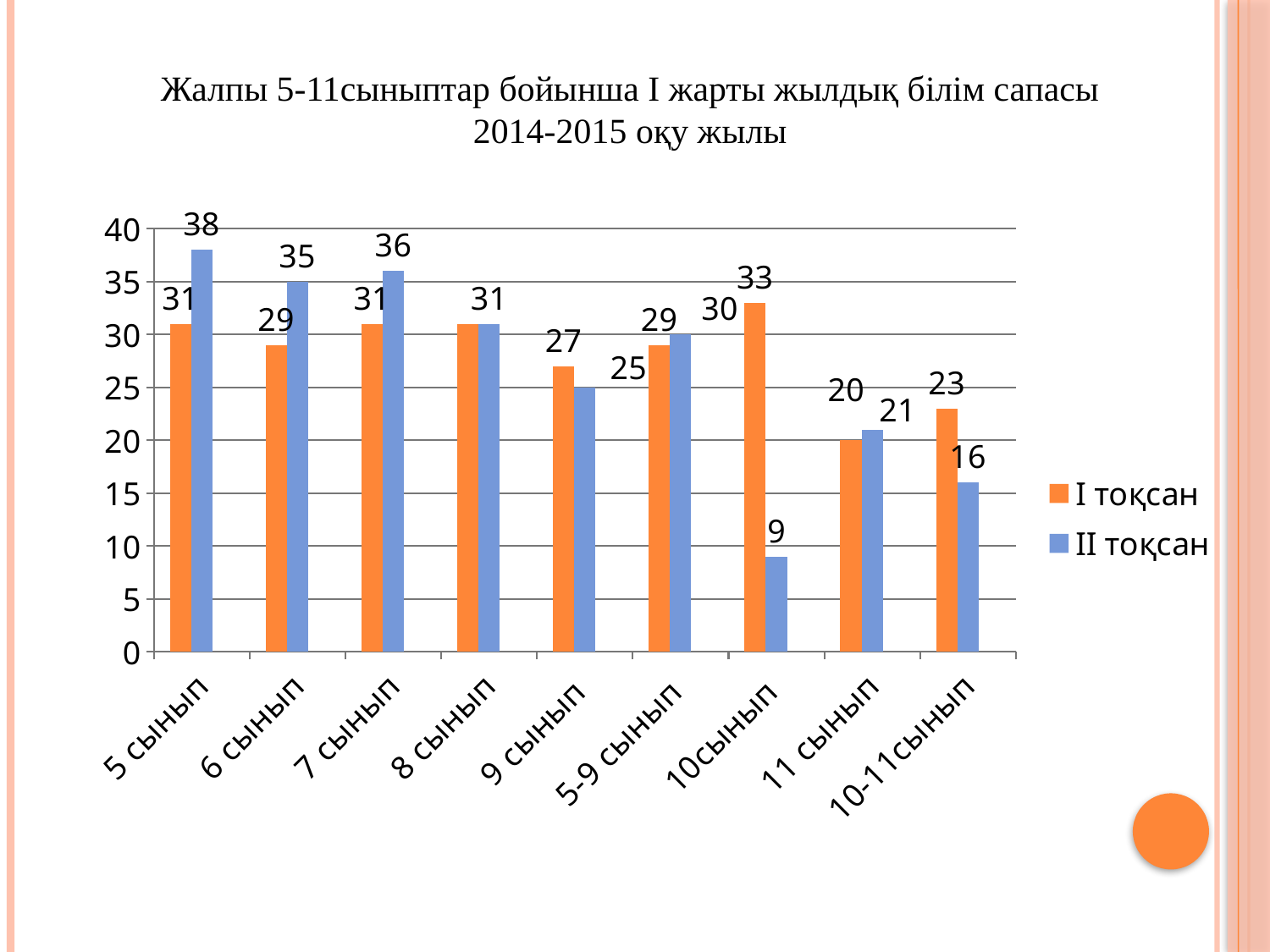
Which category has the highest II тоқсан value? 5 сынып What is the value for I тоқсан for 6 сынып? 29 How many categories are shown on the x axis? 9 Which category has the lowest II тоқсан value? 10сынып What is the value for II тоқсан for 10-11сынып? 16 What kind of chart is shown on the slide? Bar chart Which is larger for 9 сынып: I тоқсан or II тоқсан? I тоқсан What is the value for I тоқсан for 10сынып? 33 What is the value for II тоқсан for 5 сынып? 38 Which colour represents I тоқсан in the chart? Orange What is the difference between the I тоқсан and II тоқсан values for 10сынып? 24 How many series does the legend list? 2